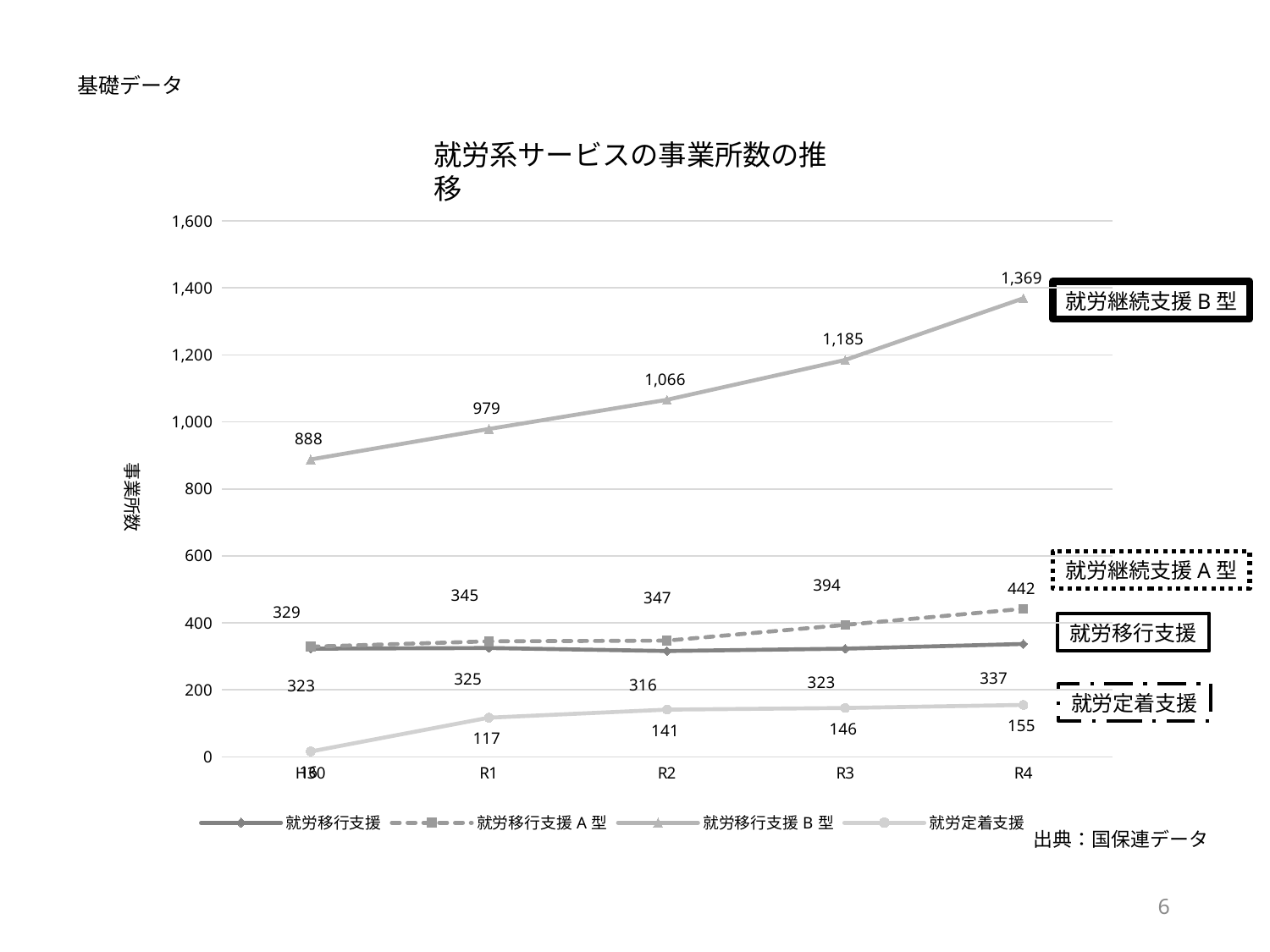
In which year is the value for 就労移行支援 B 型 the lowest? H30 In which year is the value for 就労移行支援 the highest? R4 What is the value for 就労移行支援 A 型 at R3? 394 What is the value for 就労移行支援 at H30? 323 How many series does the legend list? 4 Which is larger at R2: 就労移行支援 A 型 or 就労移行支援? 就労移行支援 A 型 What is the value for 就労定着支援 at R2? 141 What kind of chart is shown on the slide? line chart Does the value for 就労移行支援 B 型 rise or fall from H30 to R4? rise What is the value for 就労移行支援 B 型 at R4? 1,369 Is the value for 就労移行支援 B 型 at R2 greater or less than 1,000? greater What is the difference between the 就労移行支援 B 型 values at R4 and R3? 184